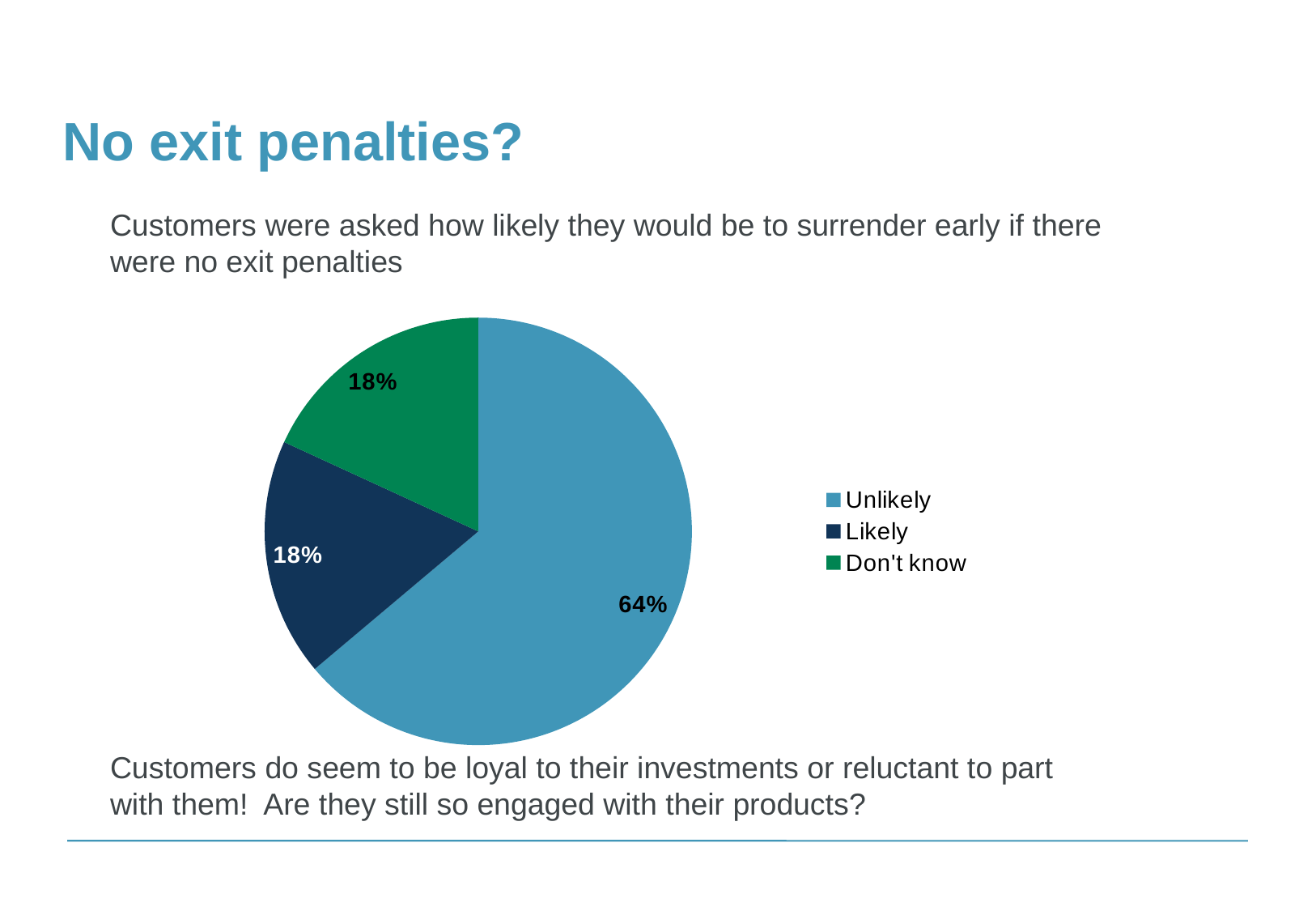
How many entries does the legend list? 3 Which legend entry is shown in dark navy blue? Likely What kind of chart is shown on the slide? pie chart What is the difference in percentage points between the 'Unlikely' and 'Likely' slices? 46 What percentage of customers said they would be unlikely to surrender early? 64% What percentage of customers said they would be likely to surrender early? 18% Which response has the largest share of the pie? Unlikely Is the share for 'Unlikely' greater or less than 50%? greater How many slices does the pie chart have? 3 What colour is the 'Don't know' slice? green Which is larger, the 'Unlikely' slice or the 'Don't know' slice? Unlikely What percentage of customers answered 'Don't know'? 18%